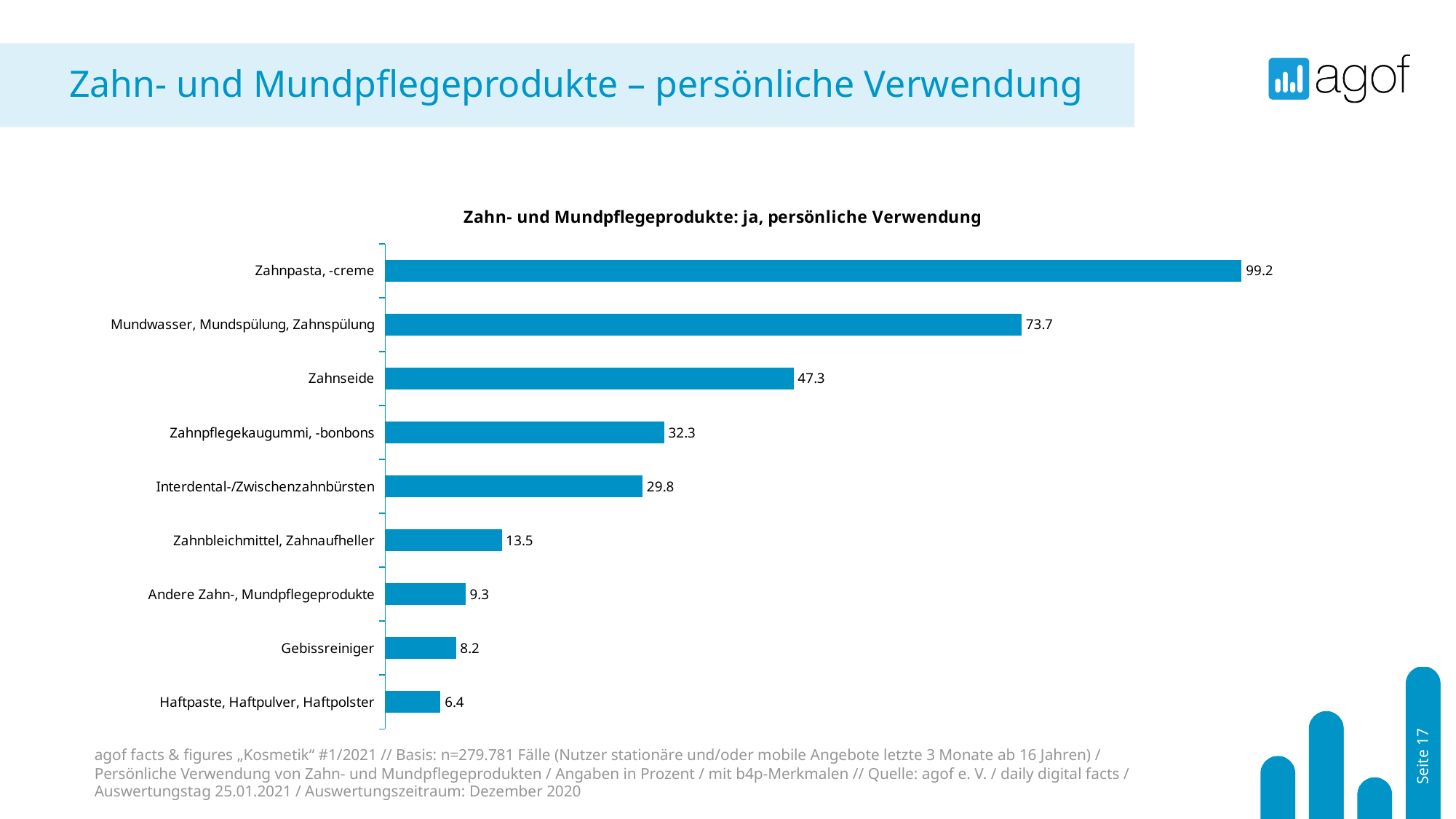
Which category has the highest value? Zahnpasta, -creme What is the title of the chart? Zahn- und Mundpflegeprodukte: ja, persönliche Verwendung What is the value for Zahnpasta, -creme? 99.2 What is the value for Interdental-/Zwischenzahnbürsten? 29.8 What is the difference between the values for Zahnpflegekaugummi, -bonbons and Interdental-/Zwischenzahnbürsten? 2.5 What is the difference between the values for Zahnpasta, -creme and Mundwasser, Mundspülung, Zahnspülung? 25.5 What kind of chart is shown on the slide? Bar chart Which is larger, the value for Zahnbleichmittel, Zahnaufheller or the value for Andere Zahn-, Mundpflegeprodukte? Zahnbleichmittel, Zahnaufheller What is the value for Zahnseide? 47.3 What is the value for Gebissreiniger? 8.2 Which category has the lowest value? Haftpaste, Haftpulver, Haftpolster How many categories are shown in the chart? 9